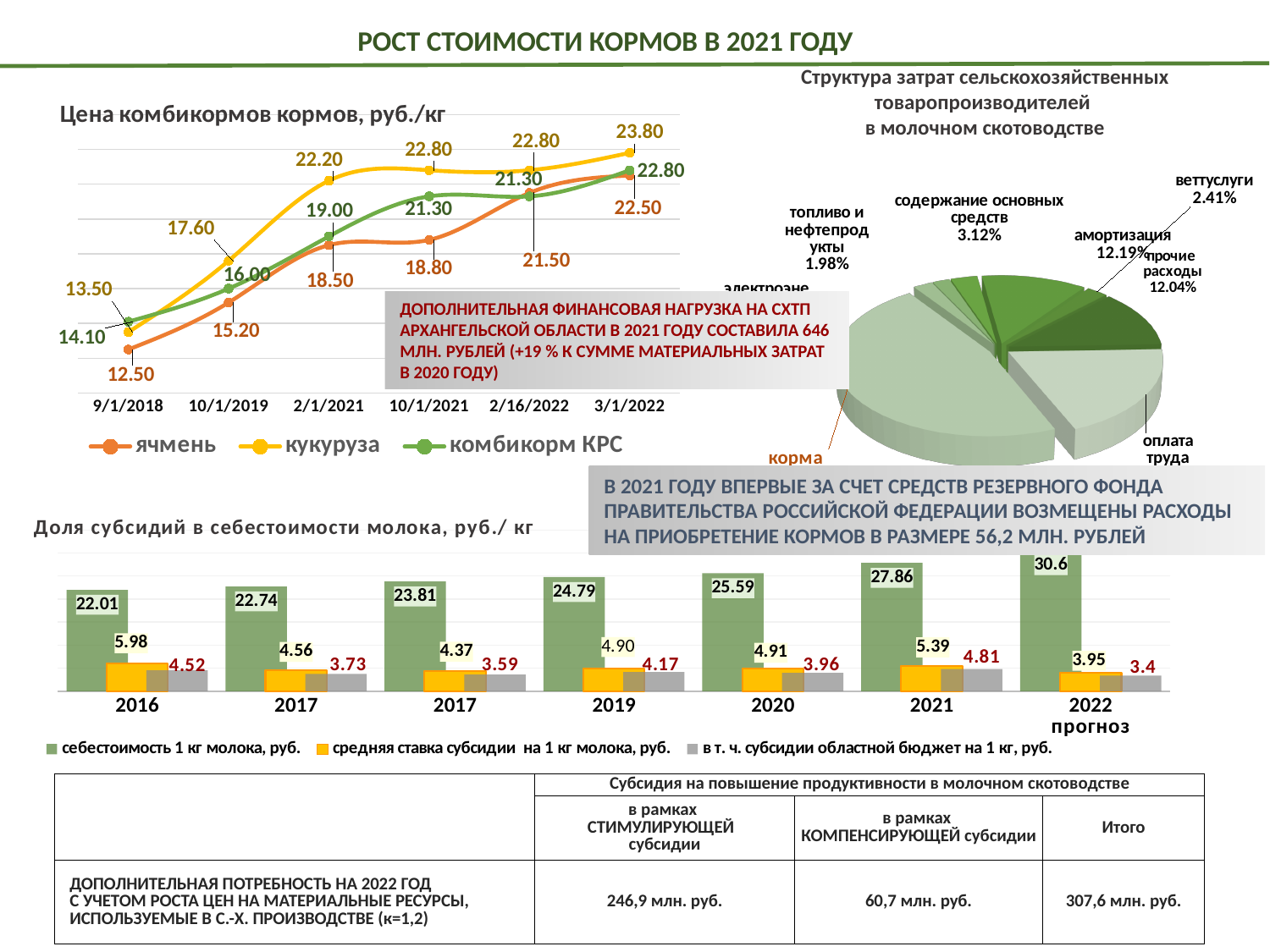
In the pie chart 'Структура затрат сельскохозяйственных товаропроизводителей в молочном скотоводстве', what share is ветуслуги? 2.41% In the line chart 'Цена комбикормов кормов, руб./кг', what is the value for кукуруза at 3/1/2022? 23.80 In the bar chart 'Доля субсидий в себестоимости молока, руб./ кг', what is the value of средняя ставка субсидии на 1 кг молока for 2016? 5.98 In the bar chart 'Доля субсидий в себестоимости молока, руб./ кг', which year has the highest себестоимость 1 кг молока? 2022 прогноз In the pie chart 'Структура затрат сельскохозяйственных товаропроизводителей в молочном скотоводстве', what share is амортизация? 12.19% What kind of chart is 'Доля субсидий в себестоимости молока, руб./ кг'? bar chart In the line chart 'Цена комбикормов кормов, руб./кг', does the price of кукуруза rise or fall from 9/1/2018 to 3/1/2022? rise In the line chart 'Цена комбикормов кормов, руб./кг', what is the difference between the кукуруза and ячмень values at 2/1/2021? 3.70 In the line chart 'Цена комбикормов кормов, руб./кг', what is the value for комбикорм КРС at 10/1/2019? 16.00 In the line chart 'Цена комбикормов кормов, руб./кг', how many series does the legend list? 3 In the bar chart 'Доля субсидий в себестоимости молока, руб./ кг', what is the value of себестоимость 1 кг молока for 2021? 27.86 In the line chart 'Цена комбикормов кормов, руб./кг', what is the value for ячмень at 9/1/2018? 12.50